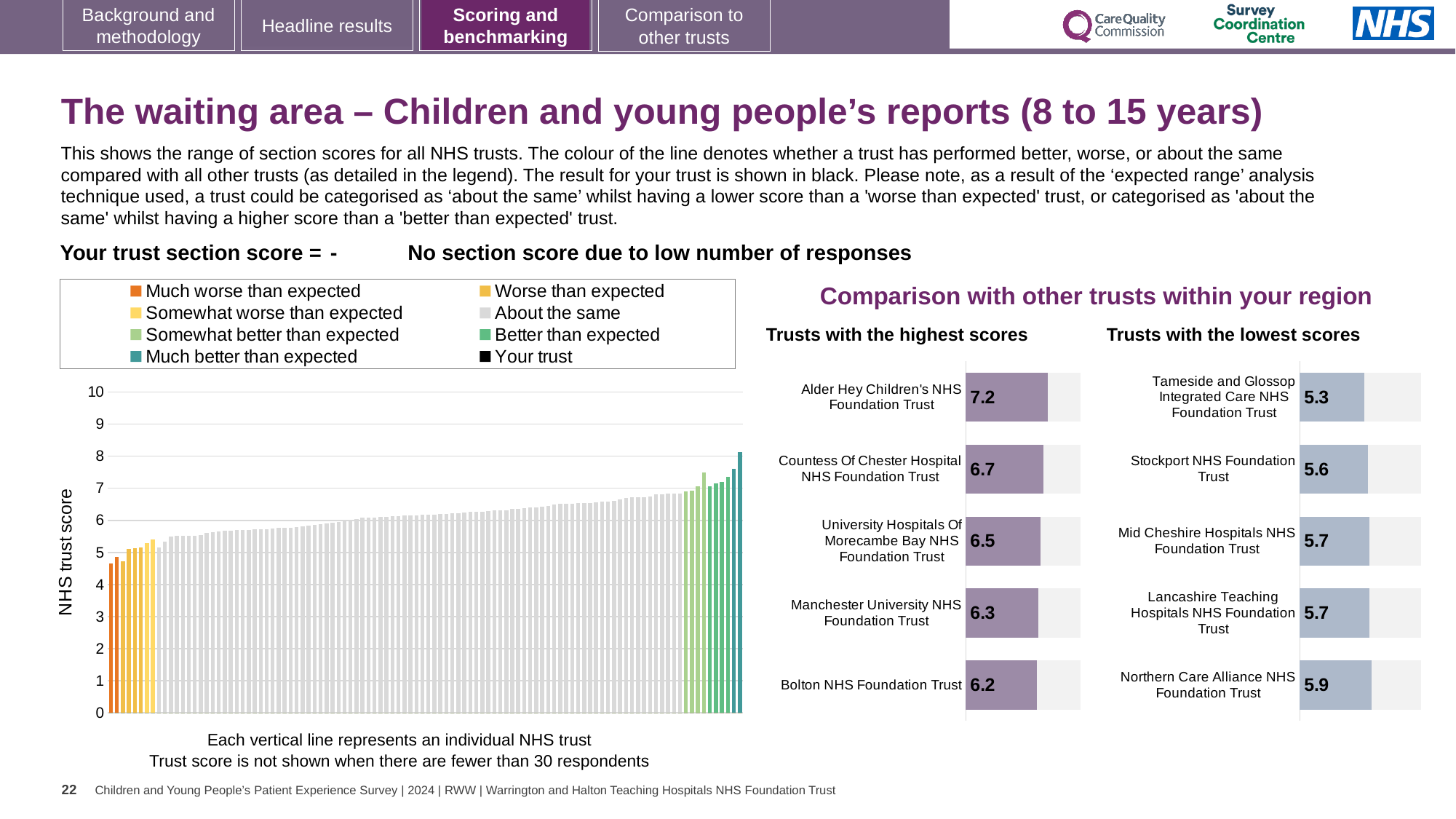
How many entries does the legend above the large 'NHS trust score' chart list? 8 In the 'Trusts with the highest scores' chart, what is the difference between the scores of Alder Hey Children's NHS Foundation Trust and Bolton NHS Foundation Trust? 1.0 In the 'Trusts with the highest scores' chart, which trust has the highest score? Alder Hey Children's NHS Foundation Trust In the 'Trusts with the lowest scores' chart, what is the score for Tameside and Glossop Integrated Care NHS Foundation Trust? 5.3 In the 'Trusts with the lowest scores' chart, which trust has the lowest score? Tameside and Glossop Integrated Care NHS Foundation Trust In the 'Trusts with the highest scores' chart, what is the score for Manchester University NHS Foundation Trust? 6.3 In the 'Trusts with the lowest scores' chart, which has the larger score: Stockport NHS Foundation Trust or Northern Care Alliance NHS Foundation Trust? Northern Care Alliance NHS Foundation Trust In the large 'NHS trust score' chart on the left, is the value of the leftmost (lowest) bar greater or less than 5? less In the large 'NHS trust score' chart on the left, do the bar values rise or fall from left to right? Rise What kind of chart is the large 'NHS trust score' chart on the left of the slide? Bar chart How many trusts are shown in the 'Trusts with the highest scores' chart? 5 In the 'Trusts with the highest scores' chart, what is the score for Alder Hey Children's NHS Foundation Trust? 7.2